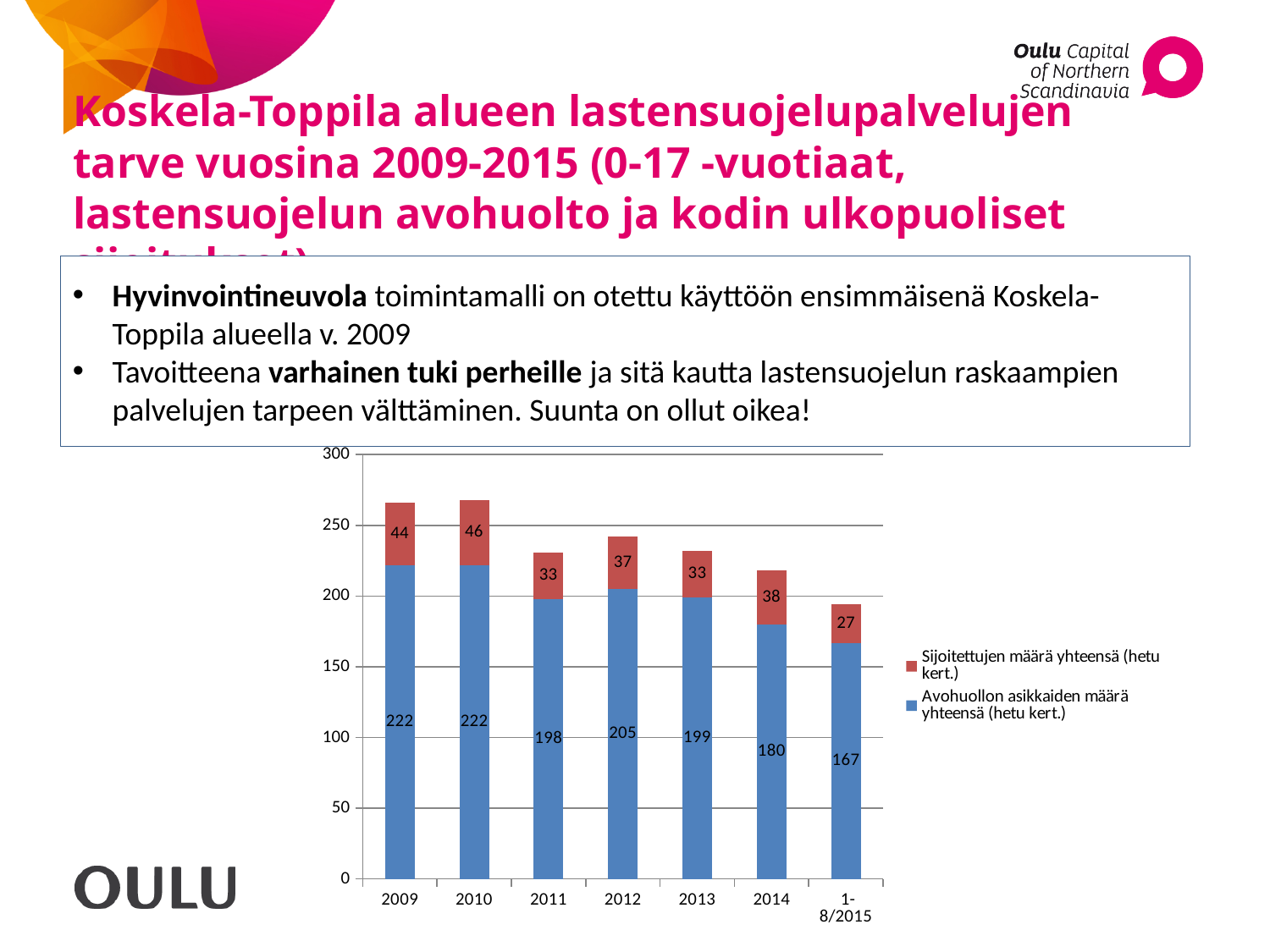
How many series does the legend list? 2 What is the difference between the Avohuollon asiakkaiden määrä yhteensä (hetu kert.) values for 2009 and 2014? 42 What is the value of Sijoitettujen määrä yhteensä (hetu kert.) for 2012? 37 Which category has the highest value for Sijoitettujen määrä yhteensä (hetu kert.)? 2010 Which category has the lowest value for Avohuollon asiakkaiden määrä yhteensä (hetu kert.)? 1-8/2015 How many categories are shown on the x axis? 7 What is the value of Avohuollon asiakkaiden määrä yhteensä (hetu kert.) for 2011? 198 Which is larger, the Sijoitettujen määrä yhteensä (hetu kert.) value for 2014 or for 2011? 2014 Do the Avohuollon asiakkaiden määrä yhteensä (hetu kert.) values generally rise or fall from 2009 to 1-8/2015? fall What type of chart is shown on the slide? stacked bar chart What is the total of the stacked bar for 2013? 232 What is the value of Avohuollon asiakkaiden määrä yhteensä (hetu kert.) for 1-8/2015? 167